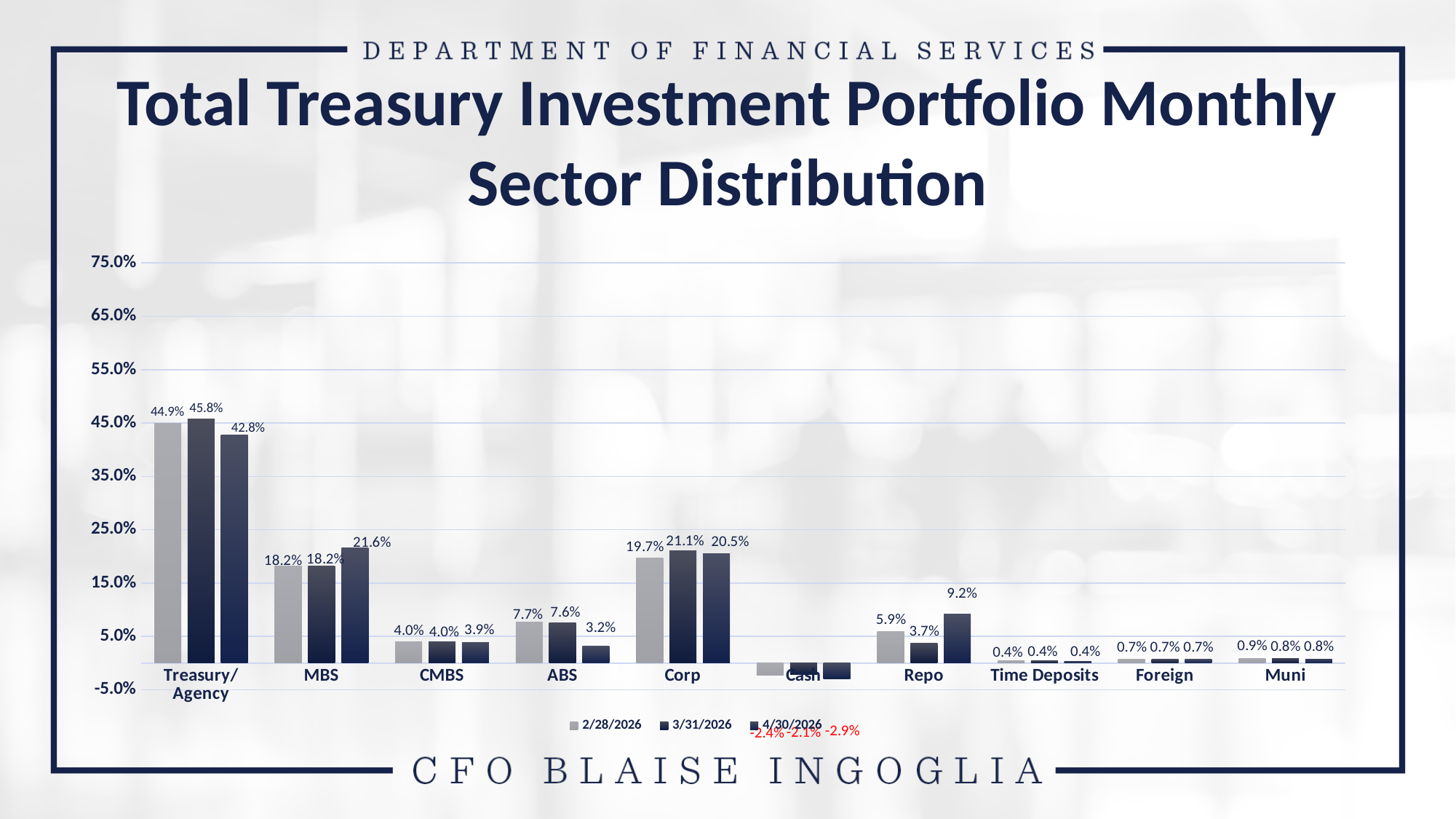
How many series does the legend list? 3 What is the title of the chart? Total Treasury Investment Portfolio Monthly Sector Distribution What is the value for Treasury/Agency for 3/31/2026? 45.8% What type of chart is shown on the slide? Bar chart Which sector has the highest value for 4/30/2026? Treasury/Agency Which sector has the lowest value for 2/28/2026? Cash What is the difference between the Treasury/Agency values for 3/31/2026 and 4/30/2026? 3.0% What is the value for MBS for 4/30/2026? 21.6% Does the ABS value rise or fall from 2/28/2026 to 4/30/2026? Fall Which is larger: the Corp value for 3/31/2026 or the Corp value for 2/28/2026? 3/31/2026 How many sector categories are shown on the x axis? 10 What is the value for Repo for 2/28/2026? 5.9%